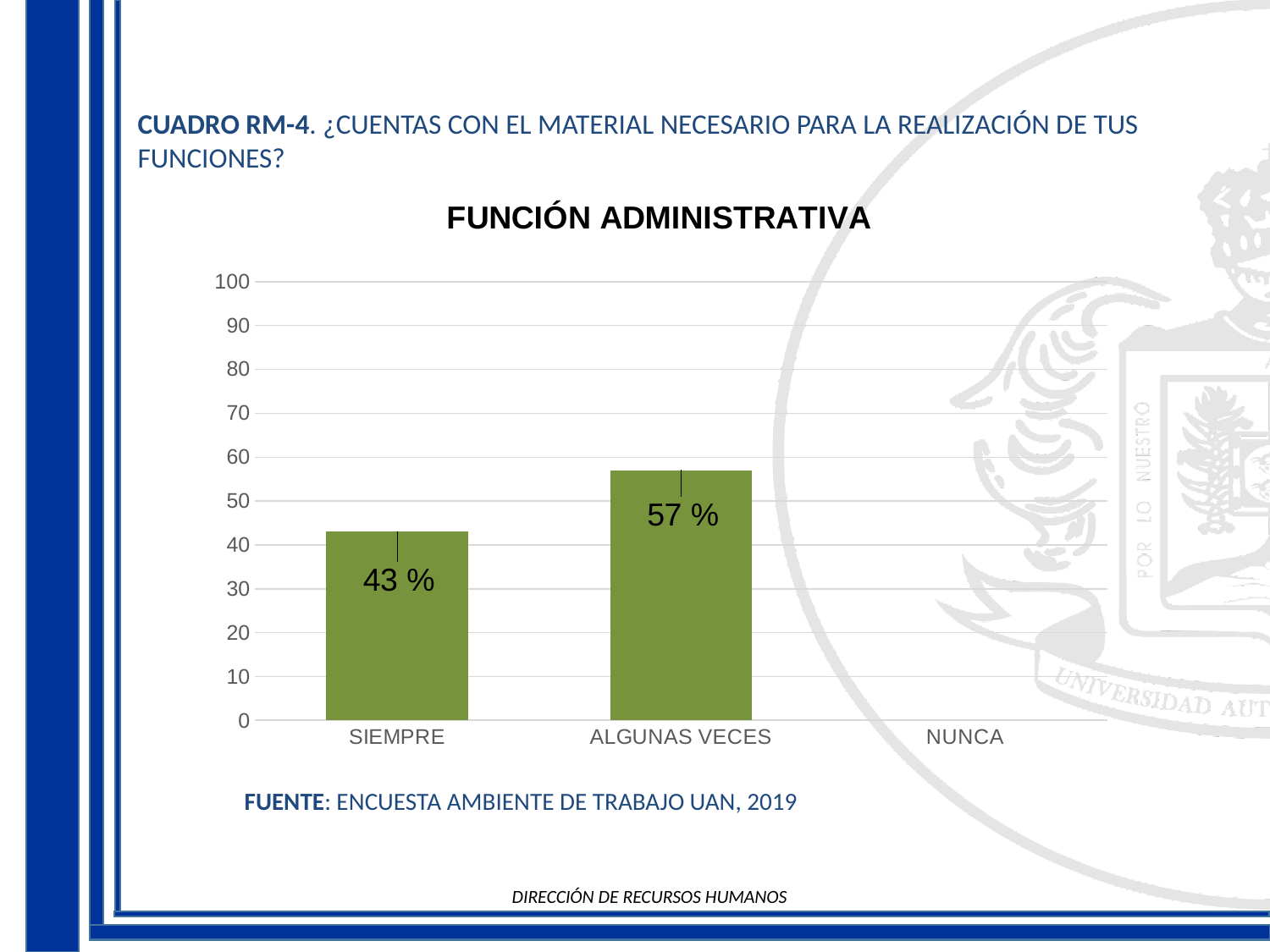
Which category has the highest value? ALGUNAS VECES Is the value for ALGUNAS VECES greater or less than 50? greater What is the title of the chart? FUNCIÓN ADMINISTRATIVA Which category has no visible bar? NUNCA What kind of chart is shown on the slide? bar chart What is the value for SIEMPRE? 43 % Is the value for SIEMPRE greater or less than 50? less How many categories are shown on the x axis? 3 What is the value for ALGUNAS VECES? 57 % What is the highest value shown on the y axis? 100 Which is larger, the value for SIEMPRE or the value for ALGUNAS VECES? ALGUNAS VECES What is the difference between the values for ALGUNAS VECES and SIEMPRE? 14 %